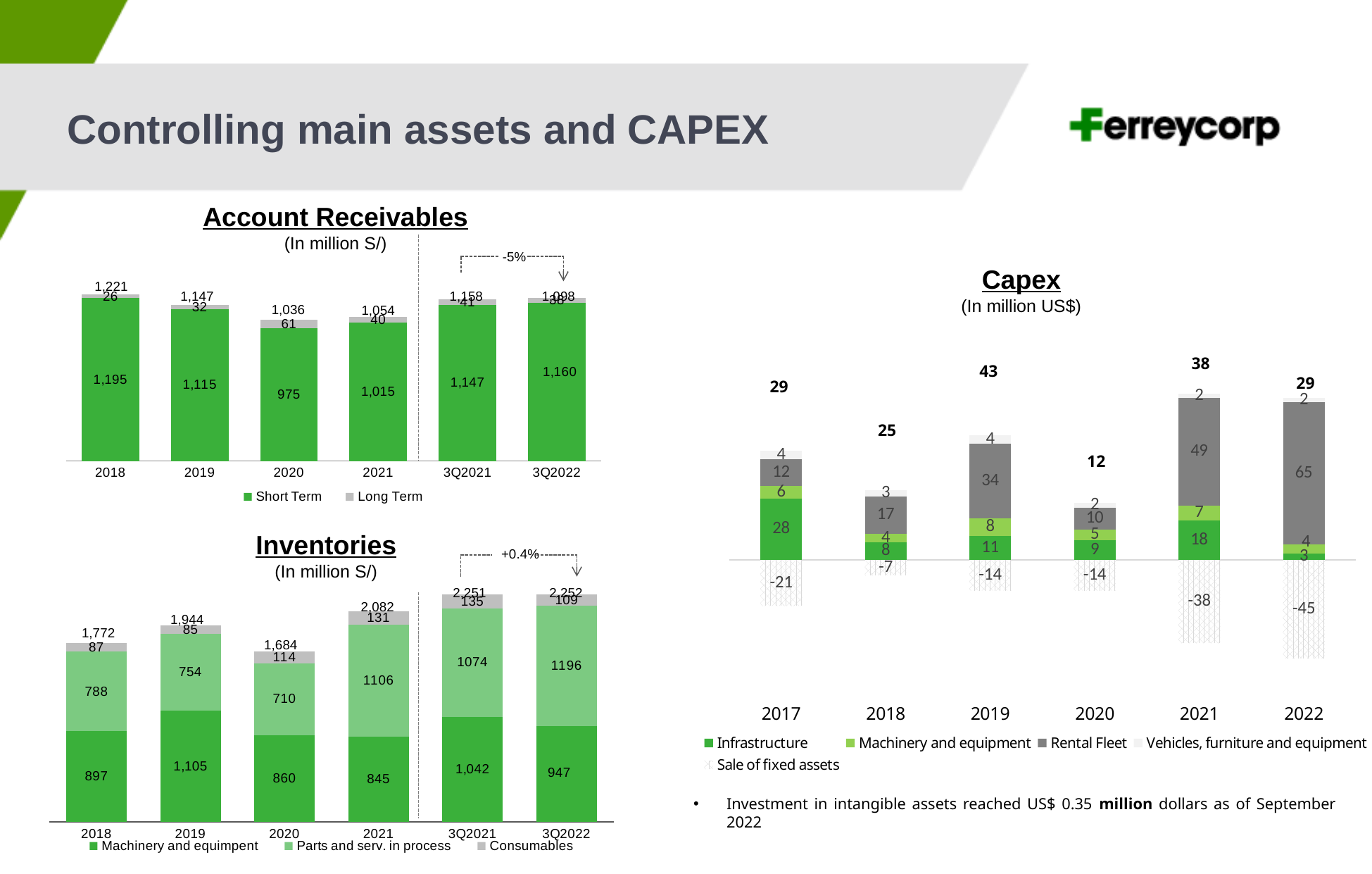
In the Account Receivables chart, what is the difference between the Long Term values for 2020 and 2018? 35 How many series does the legend of the Account Receivables chart list? 2 What type of chart is the Capex chart? Stacked bar chart In the Account Receivables chart, which year from 2018 to 2021 has the highest total? 2018 In the Inventories chart, what is the total for 2021? 2,082 In the Capex chart, which year has the lowest total? 2020 In the Account Receivables chart, what is the Short Term value for 2020? 975 In the Inventories chart, what is the difference between the Consumables values for 3Q2021 and 3Q2022? 26 In the Inventories chart, what is the Parts and serv. in process value for 3Q2022? 1196 In the Inventories chart, which is larger, the Machinery and equipment value for 2019 or for 2020? 2019 In the Capex chart, what is the Sale of fixed assets value for 2021? -38 In the Capex chart, what is the Rental Fleet value for 2022? 65